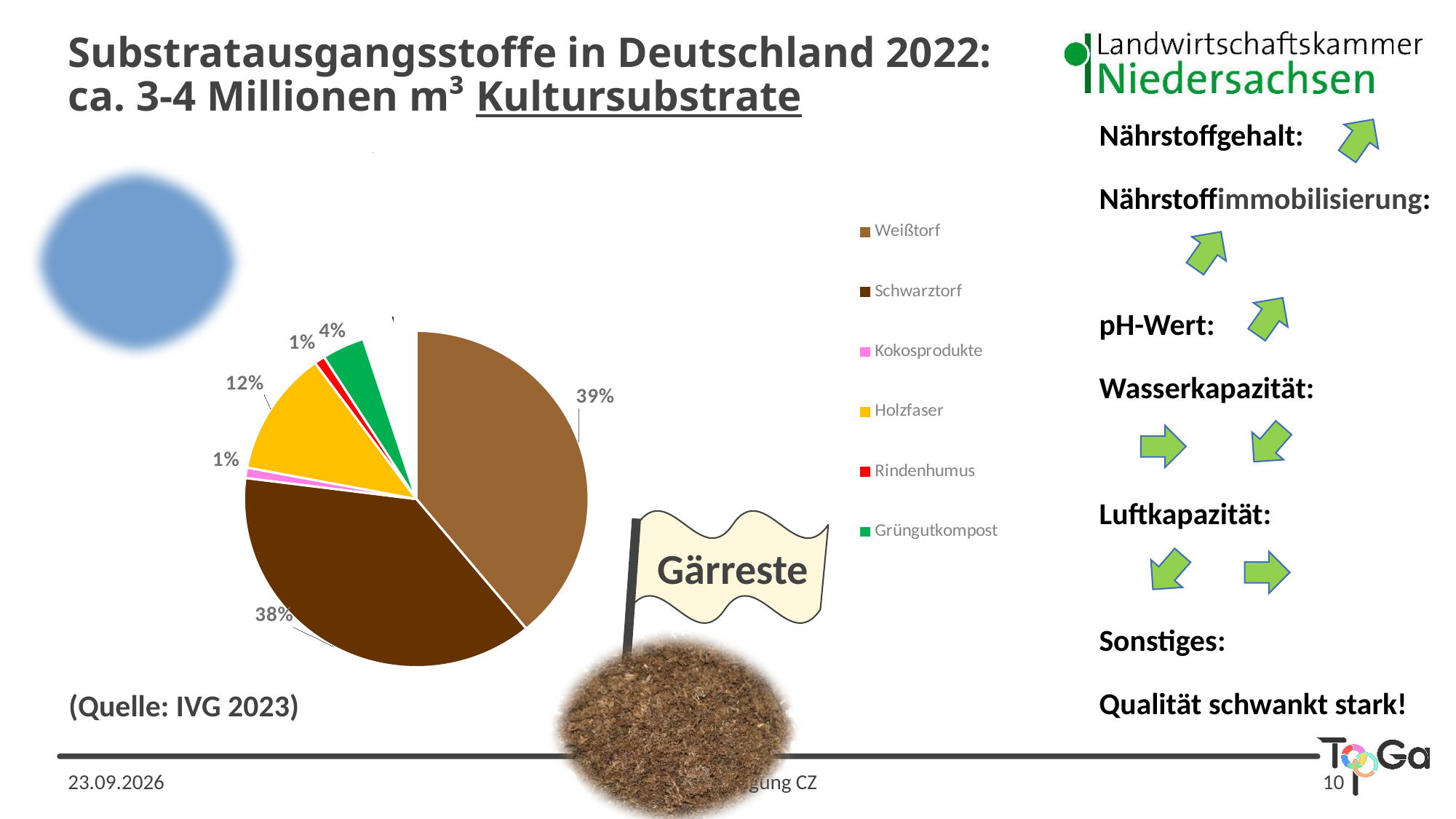
What share of the pie does Grüngutkompost have? 4% Which category has the largest slice of the pie? Weißtorf What share of the pie does Weißtorf have? 39% Which colour represents Holzfaser in the pie chart? yellow How many categories does the legend of the pie chart list? 6 Which is larger, the share for Holzfaser or the share for Grüngutkompost? Holzfaser What share of the pie does Rindenhumus have? 1% What share of the pie does Schwarztorf have? 38% What kind of chart is shown on the slide? pie chart What is the difference in percentage points between the Weißtorf and Schwarztorf shares? 1 What is the difference in percentage points between the Holzfaser and Grüngutkompost shares? 8 What share of the pie does Holzfaser have? 12%